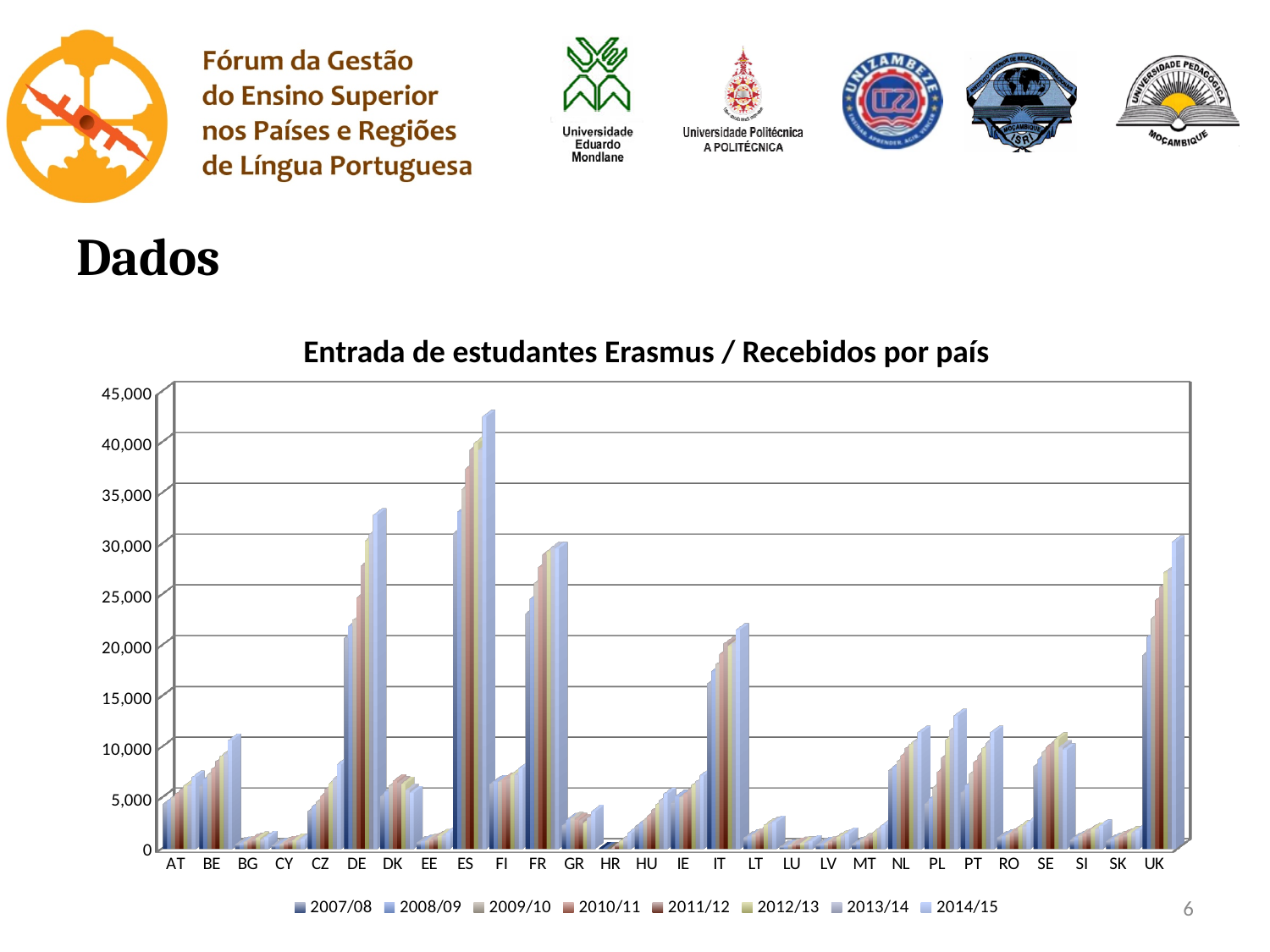
Is the value for ES in 2014/15 greater or less than 40,000? greater What kind of chart is shown on the slide? bar chart Is the value for DE in 2014/15 greater or less than 30,000? greater Which series is listed first in the legend? 2007/08 How many series does the legend list? 8 Which country has the highest bar in the chart? ES What is the title of the chart? Entrada de estudantes Erasmus / Recebidos por país Do the values for ES rise or fall from 2007/08 to 2014/15? rise Which country has the larger value in 2014/15, ES or UK? ES How many countries are shown on the x axis? 28 Is the value for IT in 2014/15 greater or less than 20,000? greater